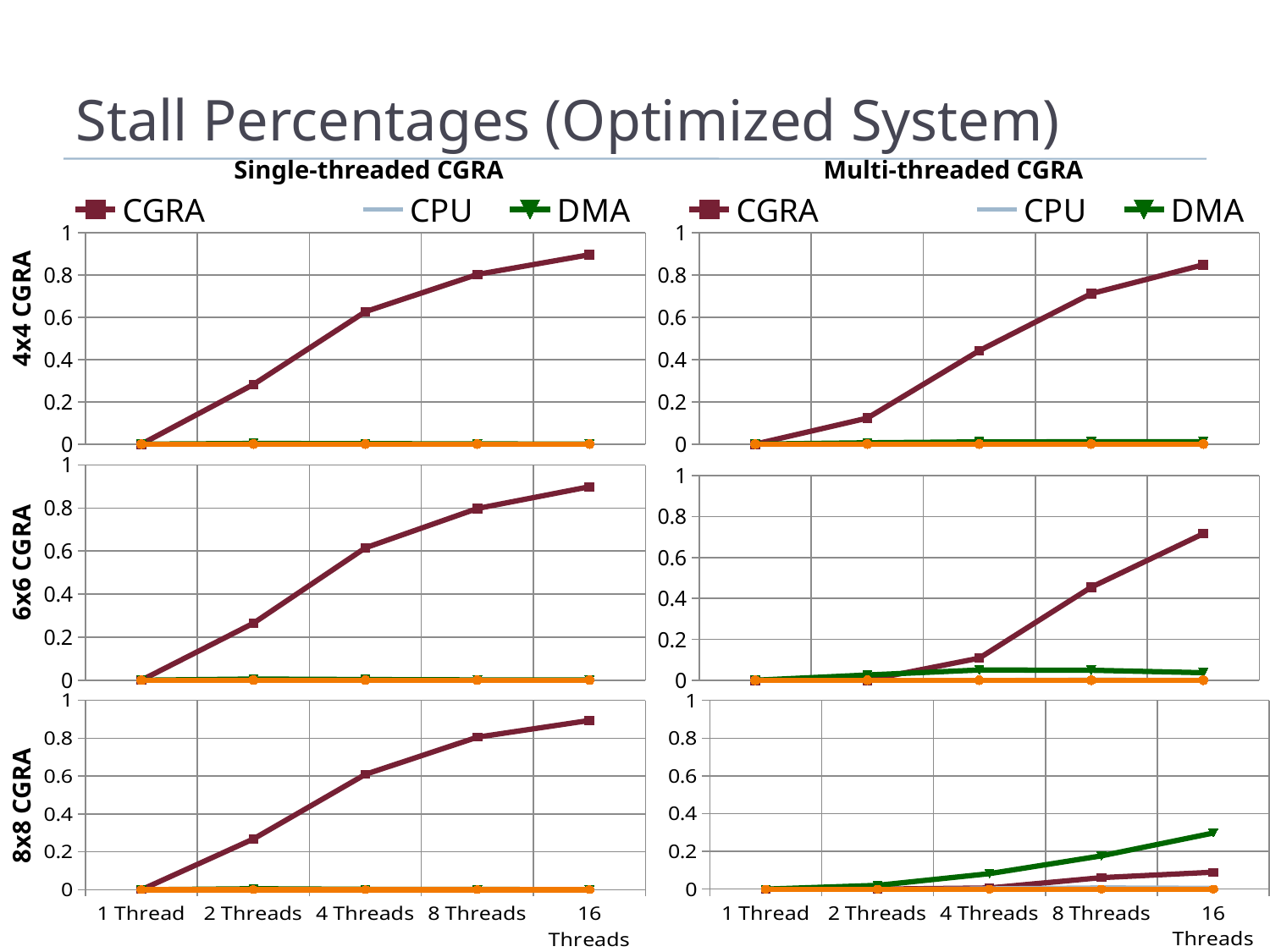
In the 4x4 CGRA Single-threaded CGRA chart, does the CGRA series rise or fall as the number of threads increases? rise In the 6x6 CGRA Multi-threaded CGRA chart, is the CGRA value at 16 Threads greater or less than 0.6? greater In the 6x6 CGRA Single-threaded CGRA chart, which series is larger at 16 Threads, CGRA or DMA? CGRA What kind of chart is used for the 4x4 CGRA Single-threaded CGRA panel? line chart What is the title of the slide? Stall Percentages (Optimized System) In the 8x8 CGRA Multi-threaded CGRA chart, is the DMA value at 16 Threads greater or less than 0.2? greater How many thread-count categories are shown on the x axis of the 8x8 CGRA Multi-threaded CGRA chart? 5 In the 4x4 CGRA Multi-threaded CGRA chart, is the CGRA value at 8 Threads greater or less than 0.6? greater How many series does the legend above the Single-threaded CGRA charts list? 3 In the 8x8 CGRA Multi-threaded CGRA chart, which series is larger at 16 Threads, CGRA or DMA? DMA